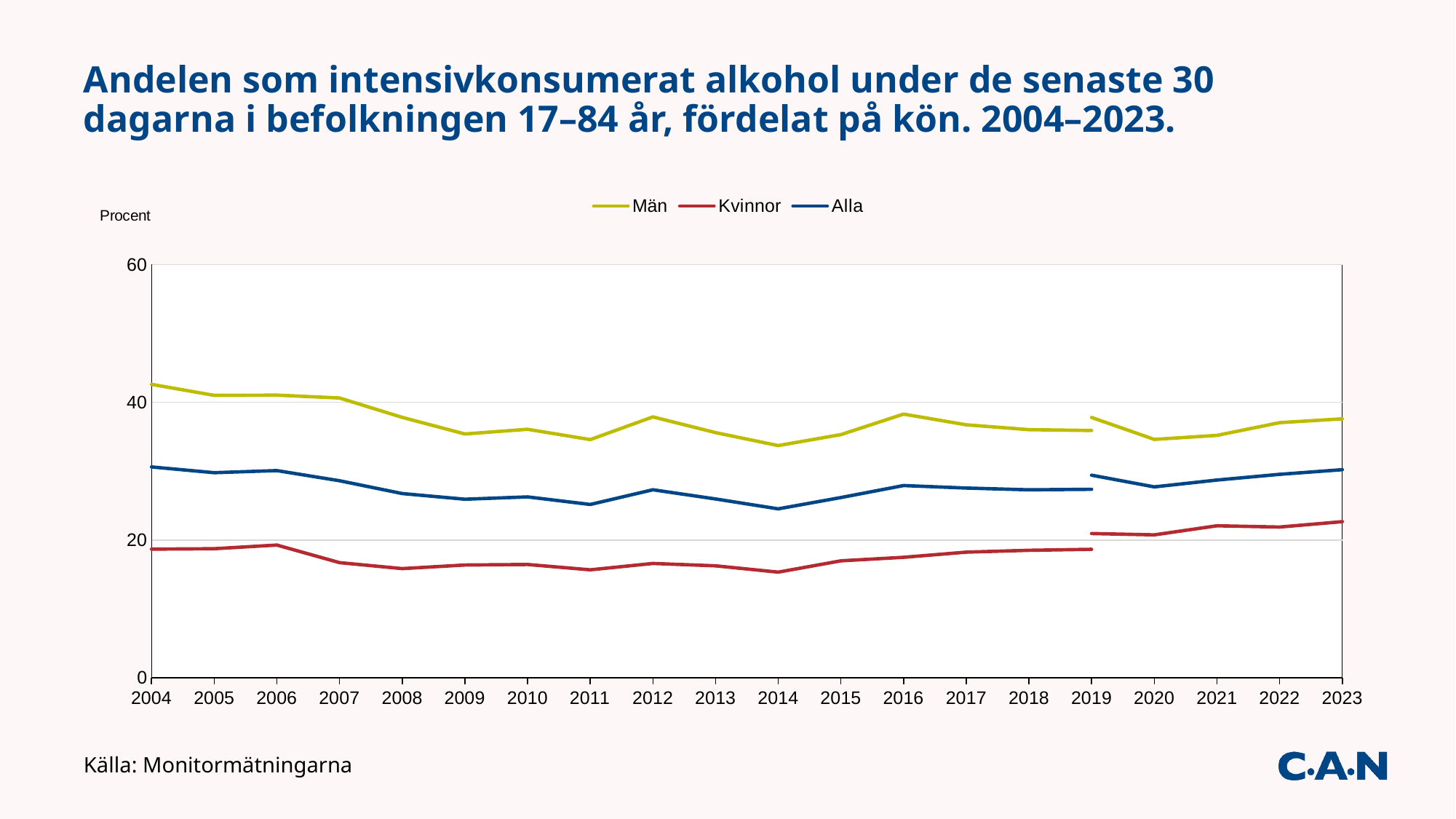
What is the label on the vertical axis? Procent Which series has the highest values throughout the chart? Män Is the value for Kvinnor in 2014 greater or less than 20? less Which is larger in 2010, the value for Män or the value for Kvinnor? Män Is the value for Män in 2004 greater or less than 40? greater How many years are plotted along the x axis? 20 What kind of chart is shown on the slide? line chart Is the value for Män in 2014 greater or less than 40? less How many series does the legend list? 3 Which series has the lowest values throughout the chart? Kvinnor Does the Män line rise or fall from 2004 to 2009? fall